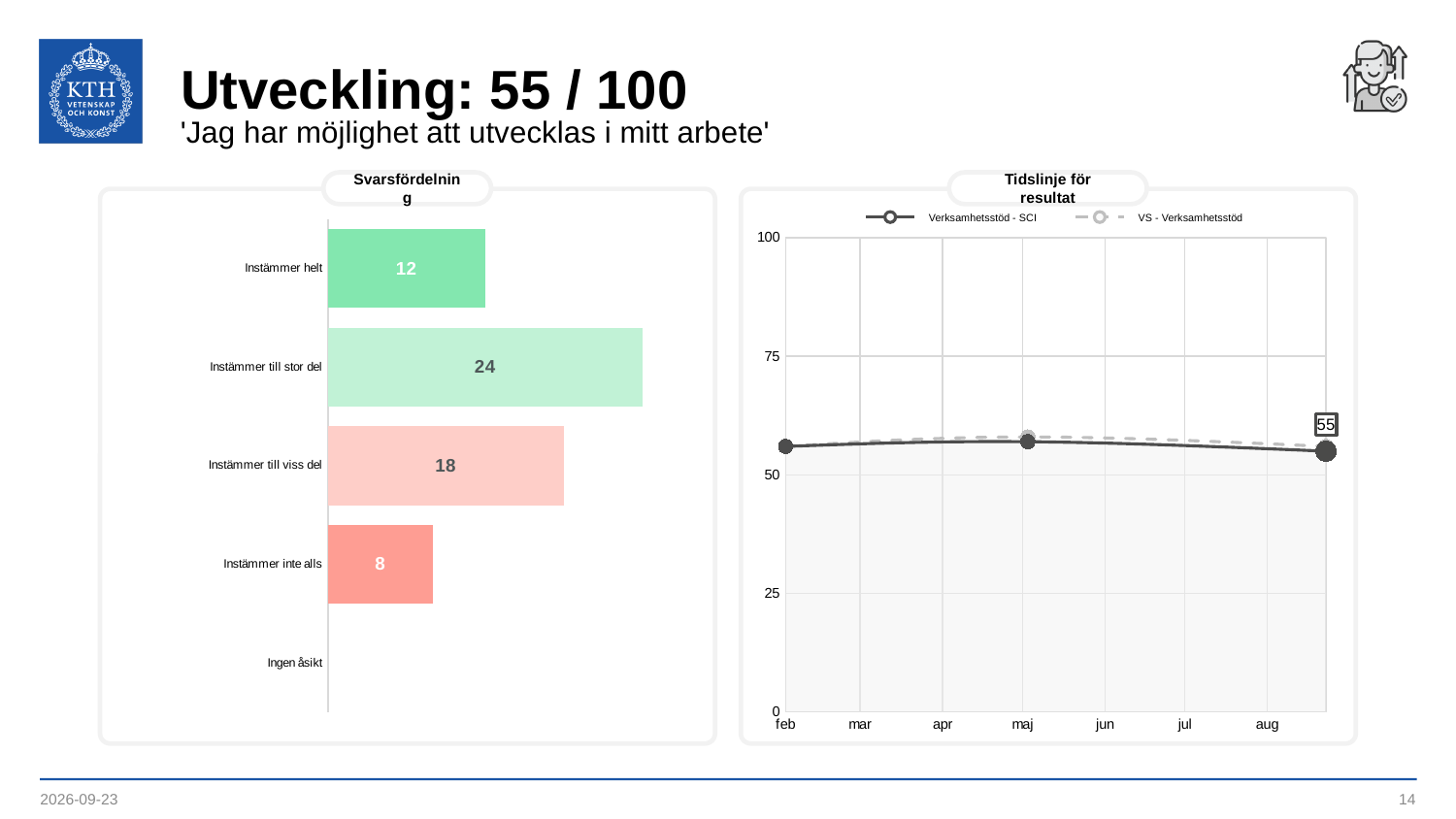
In the Svarsfördelning chart, what is the value for 'Instämmer till stor del'? 24 In the Svarsfördelning chart, what is the value for 'Instämmer inte alls'? 8 How many series does the legend of the Tidslinje för resultat chart list? 2 In the Svarsfördelning chart, which category has the highest value? Instämmer till stor del In the Tidslinje för resultat chart, is the value for feb greater or less than 75? less In the Svarsfördelning chart, which is larger: 'Instämmer helt' or 'Instämmer till viss del'? Instämmer till viss del How many categories are listed on the axis of the Svarsfördelning chart? 5 What kind of chart is the Svarsfördelning chart? Bar chart In the Svarsfördelning chart, what is the value for 'Instämmer helt'? 12 In the Tidslinje för resultat chart, what is the value of the last labelled data point? 55 In the Svarsfördelning chart, which category with a bar has the lowest value? Instämmer inte alls In the Svarsfördelning chart, what is the difference between 'Instämmer till stor del' and 'Instämmer till viss del'? 6